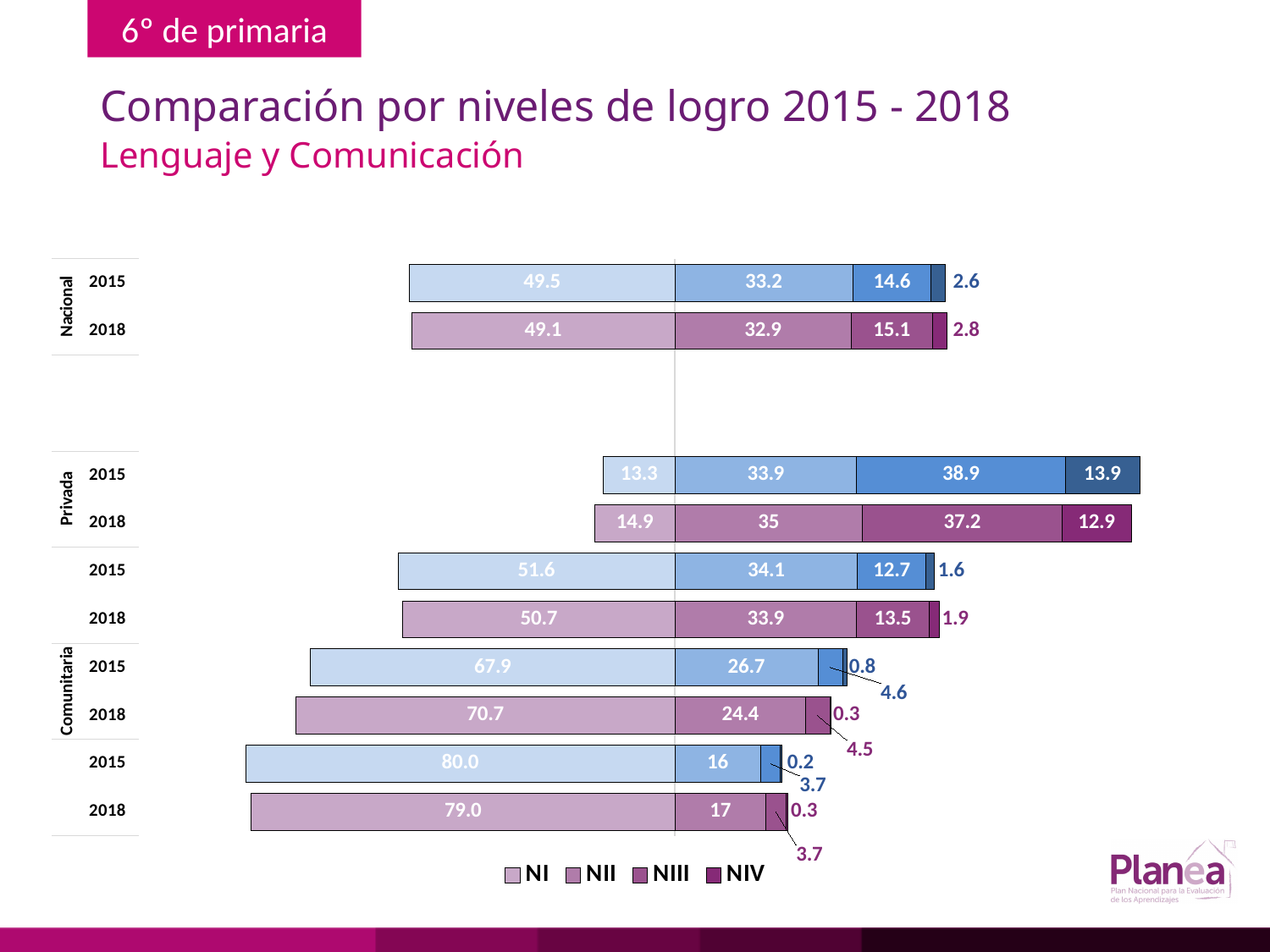
What is the NIV value for Nacional in 2018? 2.8 What is the NI value for Nacional in 2015? 49.5 What is the NIV value for Privada in 2018? 12.9 What is the total of the Nacional 2015 stacked bar? 99.9 For Privada in 2015, which is larger: the NII value or the NIII value? NIII How many series does the legend list? 4 Which level has the largest value in the Privada 2018 bar? NIII What kind of chart is shown on the slide? Stacked bar chart By how much did the NI value for Comunitaria increase from 2015 to 2018? 2.8 What is the NI value for Comunitaria in 2018? 70.7 What is the difference between the NIII value for Nacional in 2018 and in 2015? 0.5 What are the legend entries of the chart? NI, NII, NIII, NIV